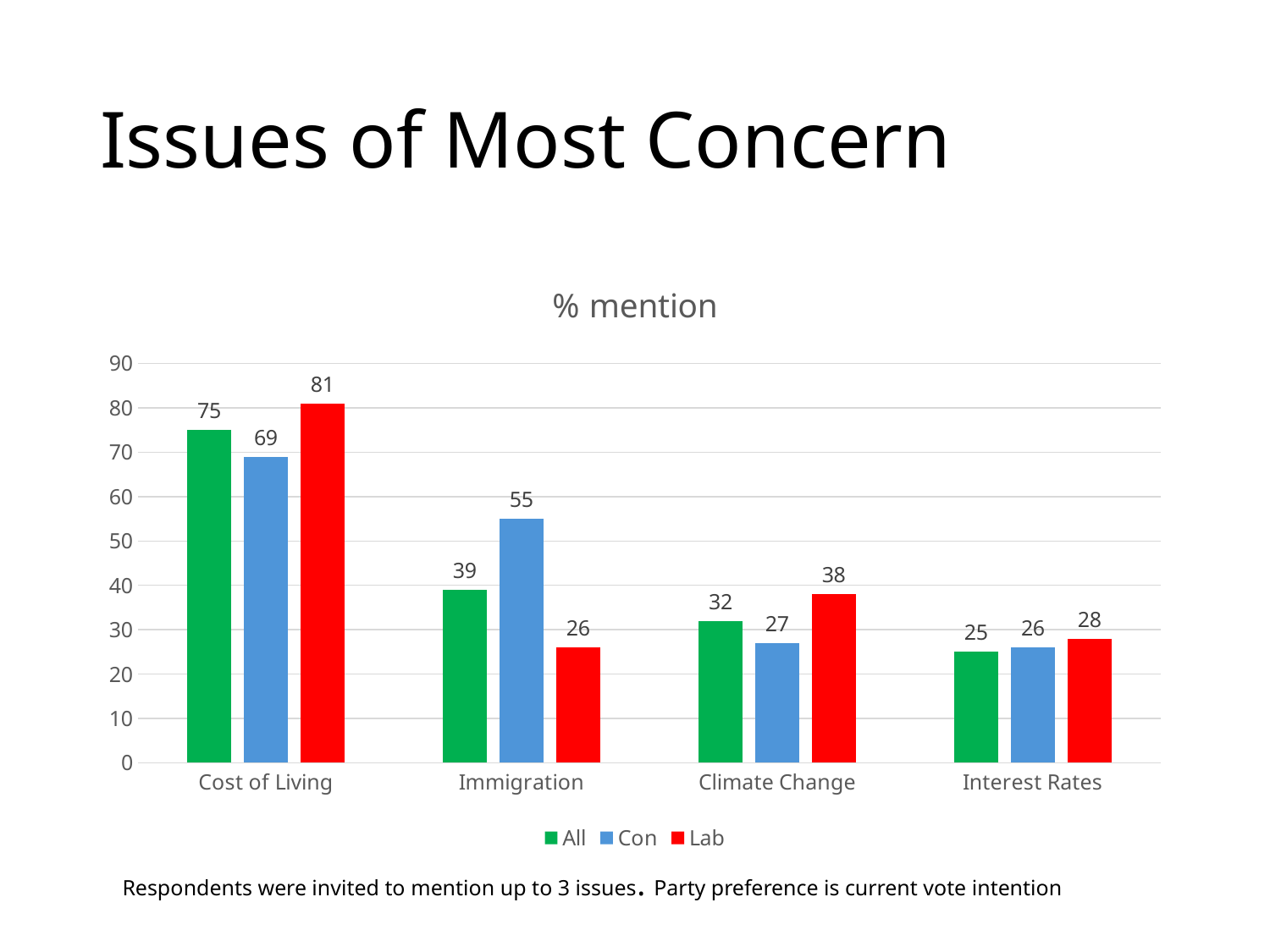
What is the value for Lab on Cost of Living? 81 Is the value for Con on Cost of Living greater or less than 60? greater What is the value for Con on Immigration? 55 What is the value for All on Climate Change? 32 Which category has the lowest value for the Lab series? Immigration Which is larger for Climate Change, the Con value or the Lab value? Lab What kind of chart is shown? bar chart Which category has the highest value for the All series? Cost of Living How many categories are shown on the x axis? 4 What is the title of the chart? % mention How many series does the legend list? 3 What is the difference between the Con and Lab values for Immigration? 29